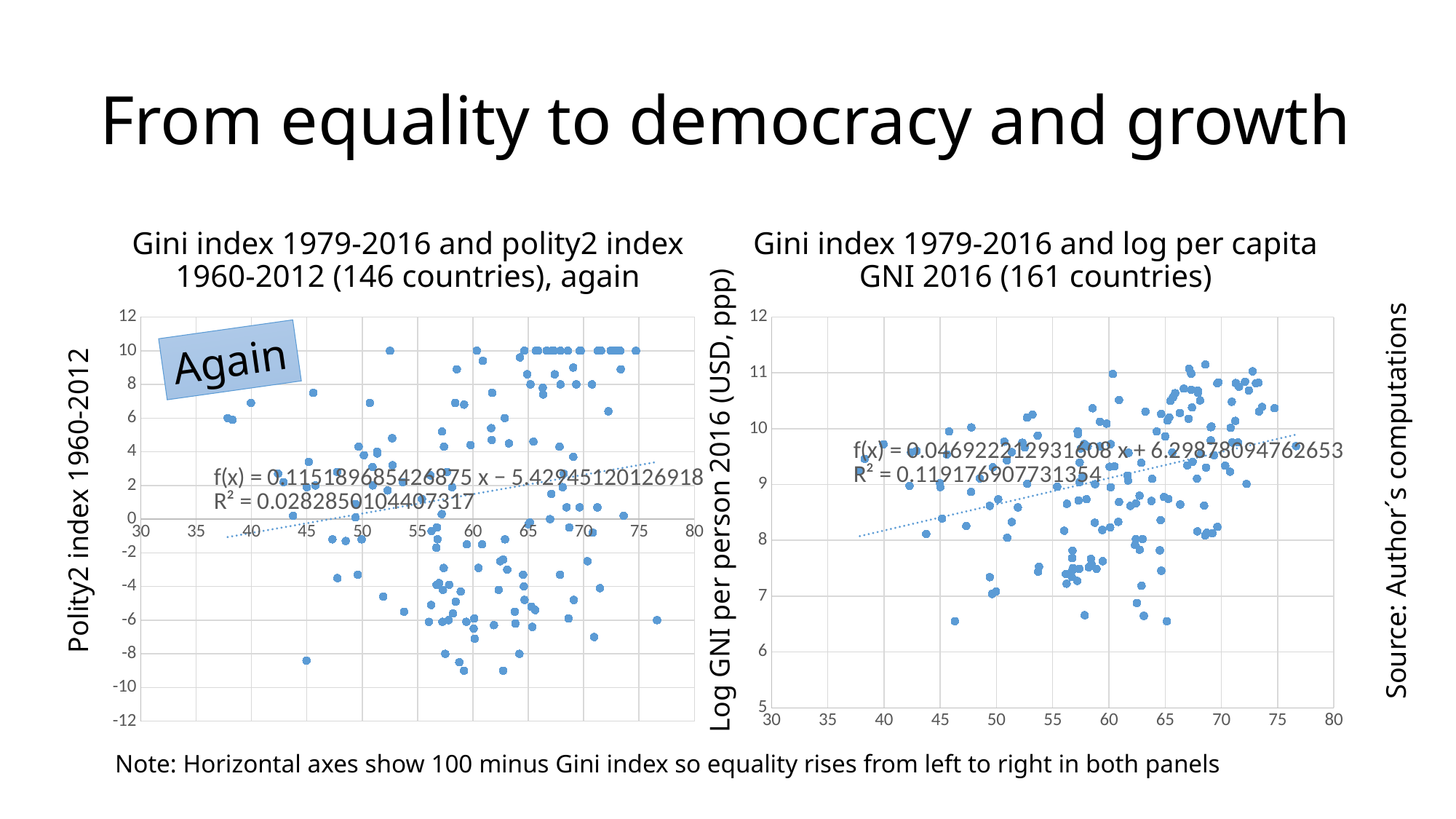
According to its title, how many countries are plotted in the right chart on log per capita GNI? 161 According to its title, how many countries are plotted in the left chart on polity2 index? 146 In the left chart on polity2 index, what is the R² value shown for the trendline? 0.0282850104407317 In the left chart on polity2 index, does the fitted trendline rise or fall from left to right? Rise What is the vertical axis label of the left chart? Polity2 index 1960-2012 What kind of chart is the left chart, 'Gini index 1979-2016 and polity2 index 1960-2012 (146 countries), again'? Scatter plot What is the vertical axis label of the right chart? Log GNI per person 2016 (USD, ppp) In the right chart on log per capita GNI, does the fitted trendline rise or fall as the horizontal axis value increases? Rise In the left chart on polity2 index, is the highest plotted polity2 value greater or less than 8? greater In the right chart on log per capita GNI, what is the R² value shown for the trendline? 0.119176907731354 Which chart has the higher R² value for its trendline, the left chart on polity2 index or the right chart on log per capita GNI? The right chart on log per capita GNI What kind of chart is the right chart, 'Gini index 1979-2016 and log per capita GNI 2016 (161 countries)'? Scatter plot